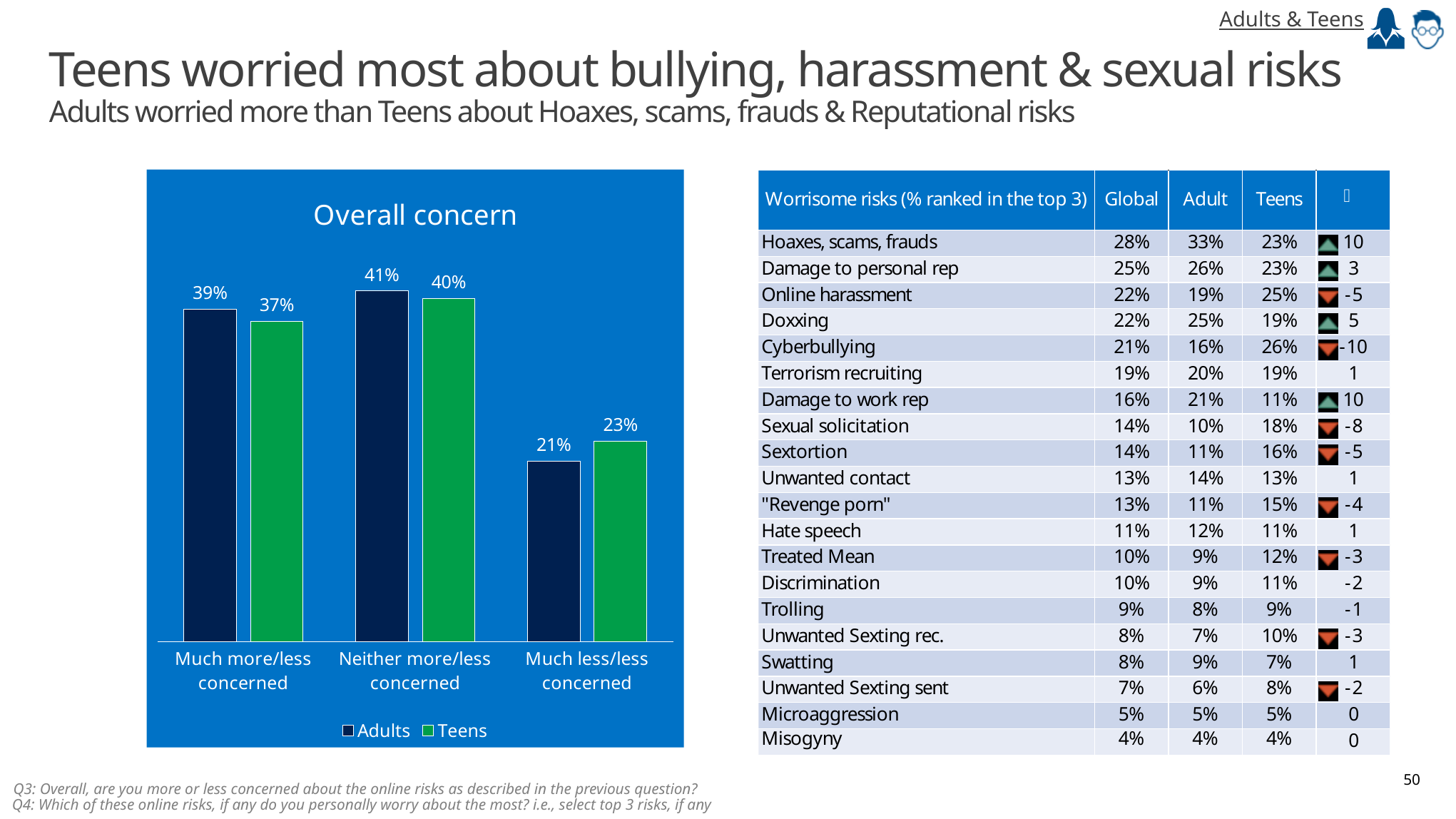
How many categories are shown on the x axis of the Overall concern chart? 3 In the Overall concern chart, what is the difference between the Adults and Teens values in the 'Much less/less concerned' category? 2% In the Overall concern chart, what is the value for Teens in the 'Much less/less concerned' category? 23% In the Overall concern chart, what is the value for Adults in the 'Much more/less concerned' category? 39% How many series does the legend of the Overall concern chart list? 2 In the Overall concern chart, what is the value for Teens in the 'Neither more/less concerned' category? 40% In the Overall concern chart, what is the value for Adults in the 'Much less/less concerned' category? 21% What type of chart is the Overall concern chart? Bar chart In the Overall concern chart, what is the difference between the Adults values for 'Neither more/less concerned' and 'Much less/less concerned'? 20% In the Overall concern chart, which is larger in the 'Much more/less concerned' category: Adults or Teens? Adults In the Overall concern chart, which category has the lowest value for Teens? Much less/less concerned In the Overall concern chart, which category has the highest value for Adults? Neither more/less concerned